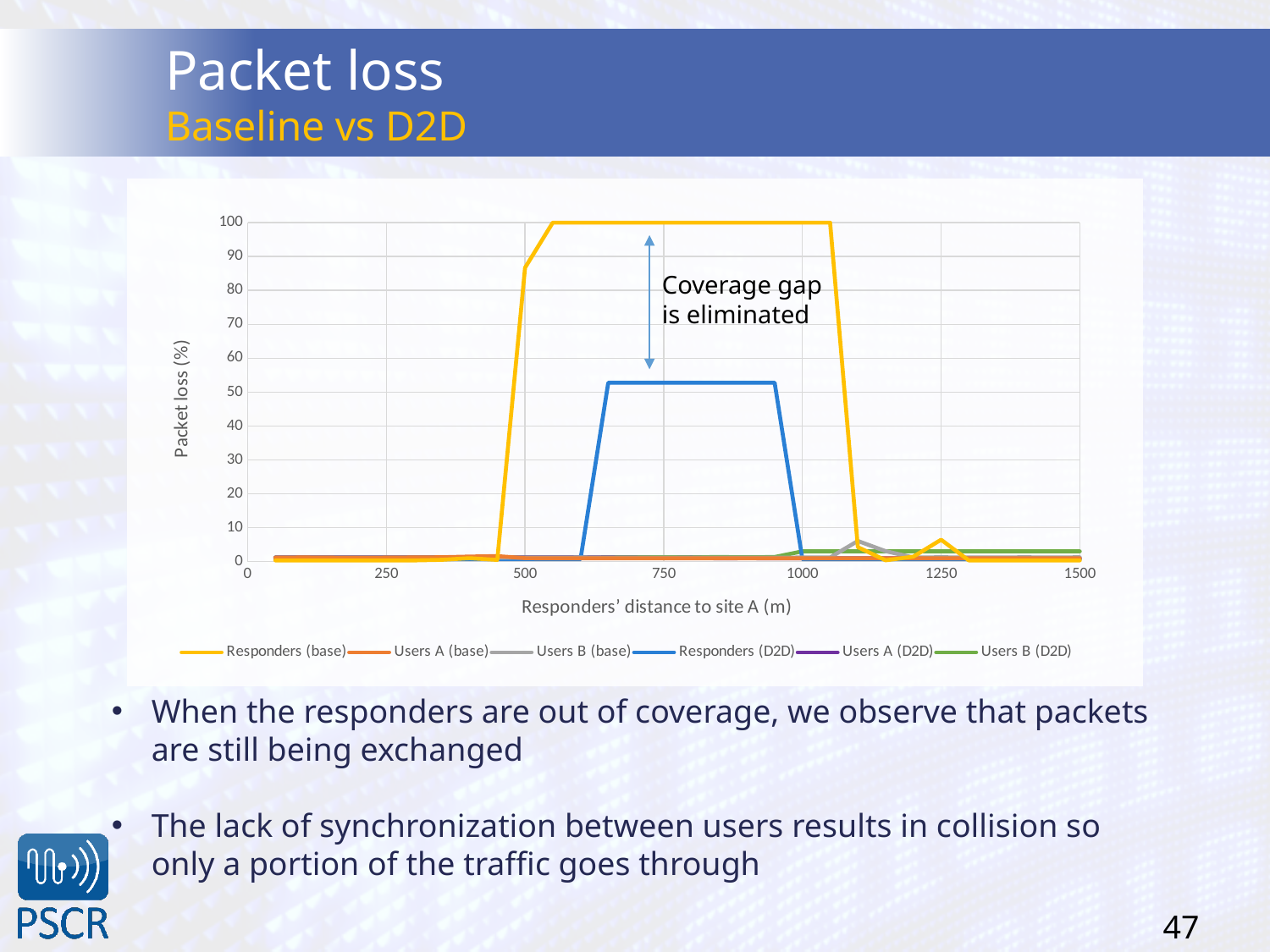
What is the label of the y axis? Packet loss (%) Is the packet loss for Responders (base) at 250 m greater or less than 10? less Does the packet loss for Responders (base) rise or fall between 1000 m and 1250 m? fall Is the packet loss for Responders (D2D) at 750 m greater or less than 60? less What kind of chart is shown on the slide? line chart Which series reaches the highest packet loss on the chart? Responders (base) What is the packet loss for Responders (base) at a distance of 750 m? 100 At 750 m, which series has the higher packet loss, Responders (base) or Responders (D2D)? Responders (base) Is the packet loss for Responders (D2D) at 1250 m greater or less than 10? less What is the label of the x axis? Responders' distance to site A (m) How many series does the legend list? 6